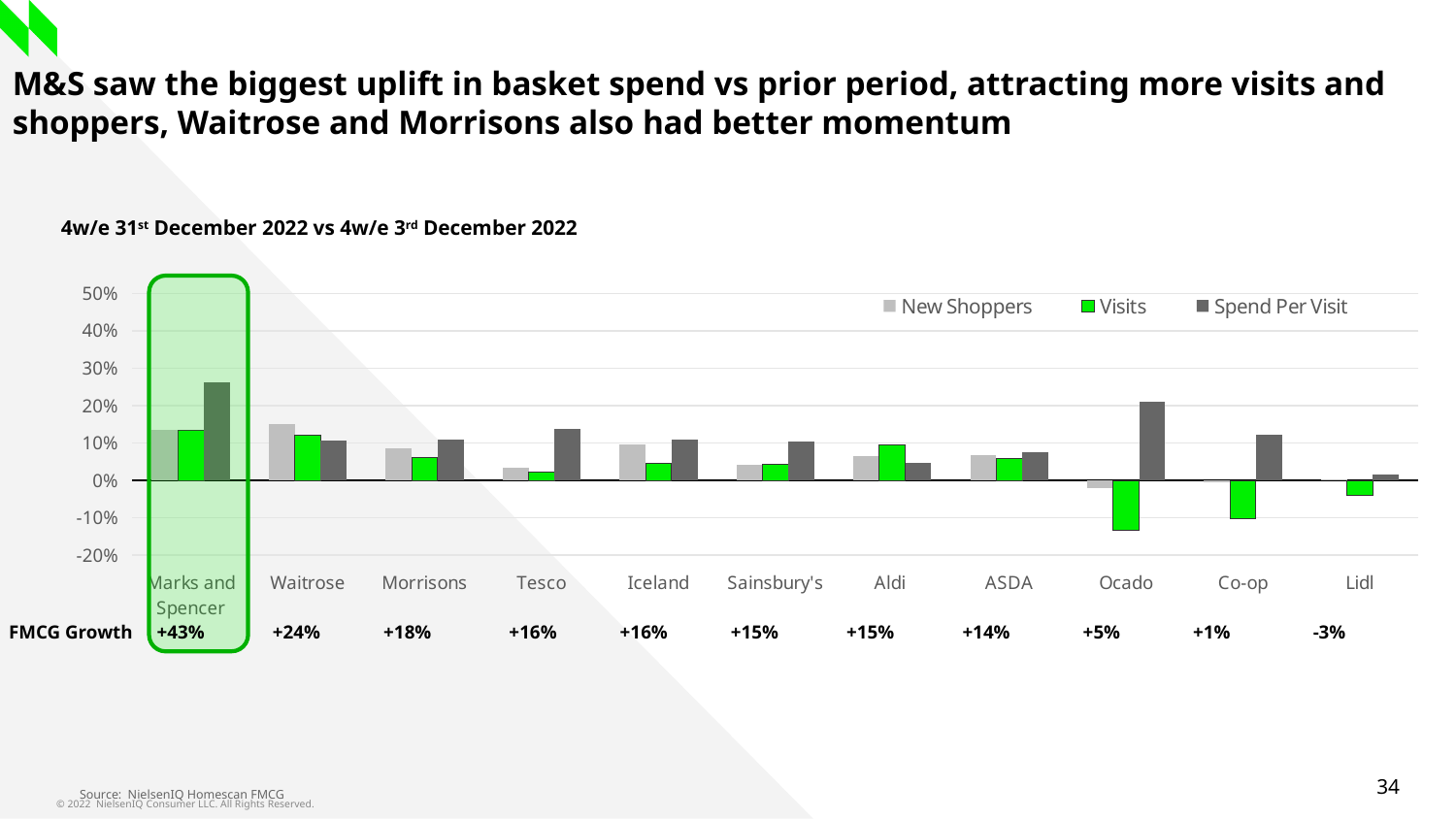
How many series does the chart legend list? 3 Is the Visits value for Ocado greater or less than -10%? less Which retailer has the highest Spend Per Visit value in the chart? Marks and Spencer Which is larger: the Spend Per Visit value for Marks and Spencer or the Spend Per Visit value for Waitrose? Marks and Spencer Is the Visits value for Lidl greater or less than 0%? less Is the Spend Per Visit value for Marks and Spencer greater or less than 20%? greater Which is larger for Tesco: the Visits value or the Spend Per Visit value? Spend Per Visit What colour are the Visits bars in the chart? green How many retailers are shown along the x axis of the chart? 11 Which retailer has the lowest Visits value in the chart? Ocado What kind of chart is shown on the slide? bar chart